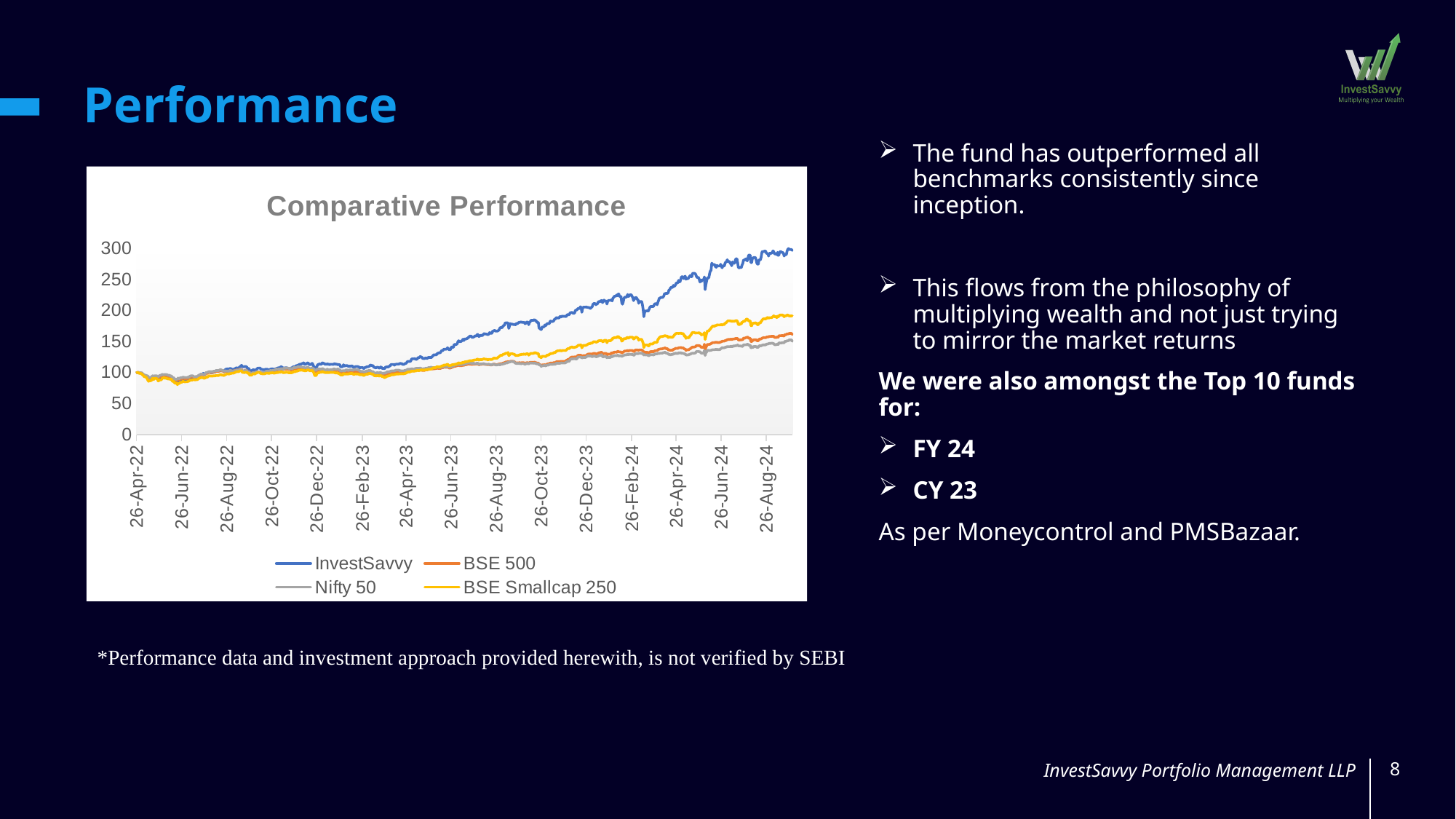
How many series does the chart's legend list? 4 Which series has the highest value at the end of the chart (26-Aug-24)? InvestSavvy Is the value of the InvestSavvy line at the end of the chart greater or less than 250? greater Which series are listed in the chart's legend? InvestSavvy, BSE 500, Nifty 50, BSE Smallcap 250 What is the title of the chart? Comparative Performance Is the value of the Nifty 50 line at the end of the chart greater or less than 200? less Is the value of the BSE Smallcap 250 line at the end of the chart greater or less than 150? greater What is the highest value shown on the chart's y axis? 300 At the end of the chart, which is larger: the InvestSavvy line or the Nifty 50 line? InvestSavvy What kind of chart is shown on the slide? Line chart Does the InvestSavvy line generally rise or fall from 26-Apr-22 to 26-Aug-24? Rise How many date labels are shown on the x axis of the chart? 15